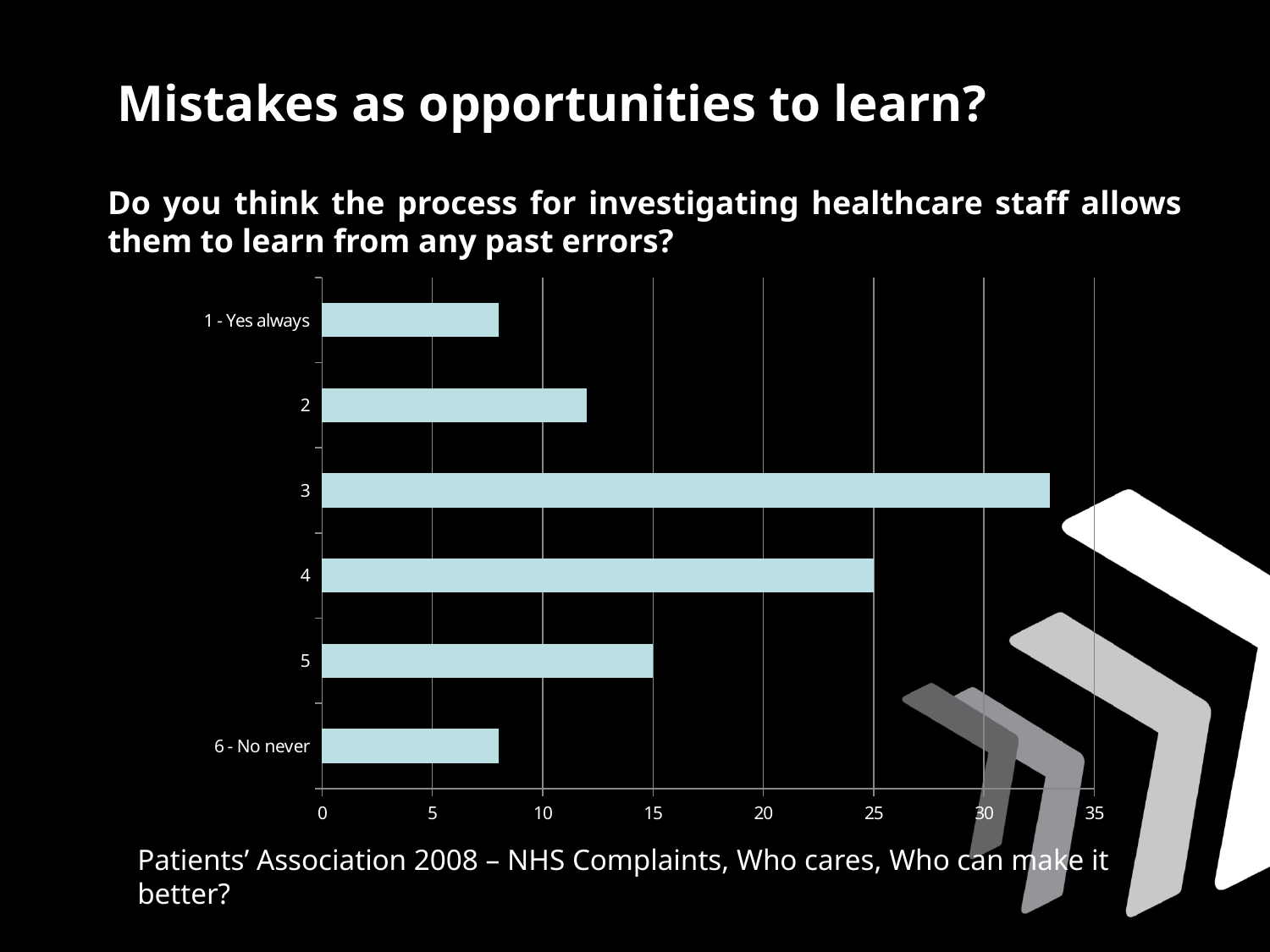
What kind of chart is shown on the slide? bar chart Which response category has the highest value? 3 Is the value for category 2 greater or less than 10? greater How many response categories are shown on the chart? 6 What is the label of the first (top) category on the chart? 1 - Yes always Is the value for '6 - No never' greater or less than 10? less Is the value for '1 - Yes always' greater or less than 10? less Which is larger, the value for category 3 or the value for category 4? 3 What is the value for response category 5? 15 What is the value for response category 4? 25 What is the difference between the values for categories 4 and 5? 10